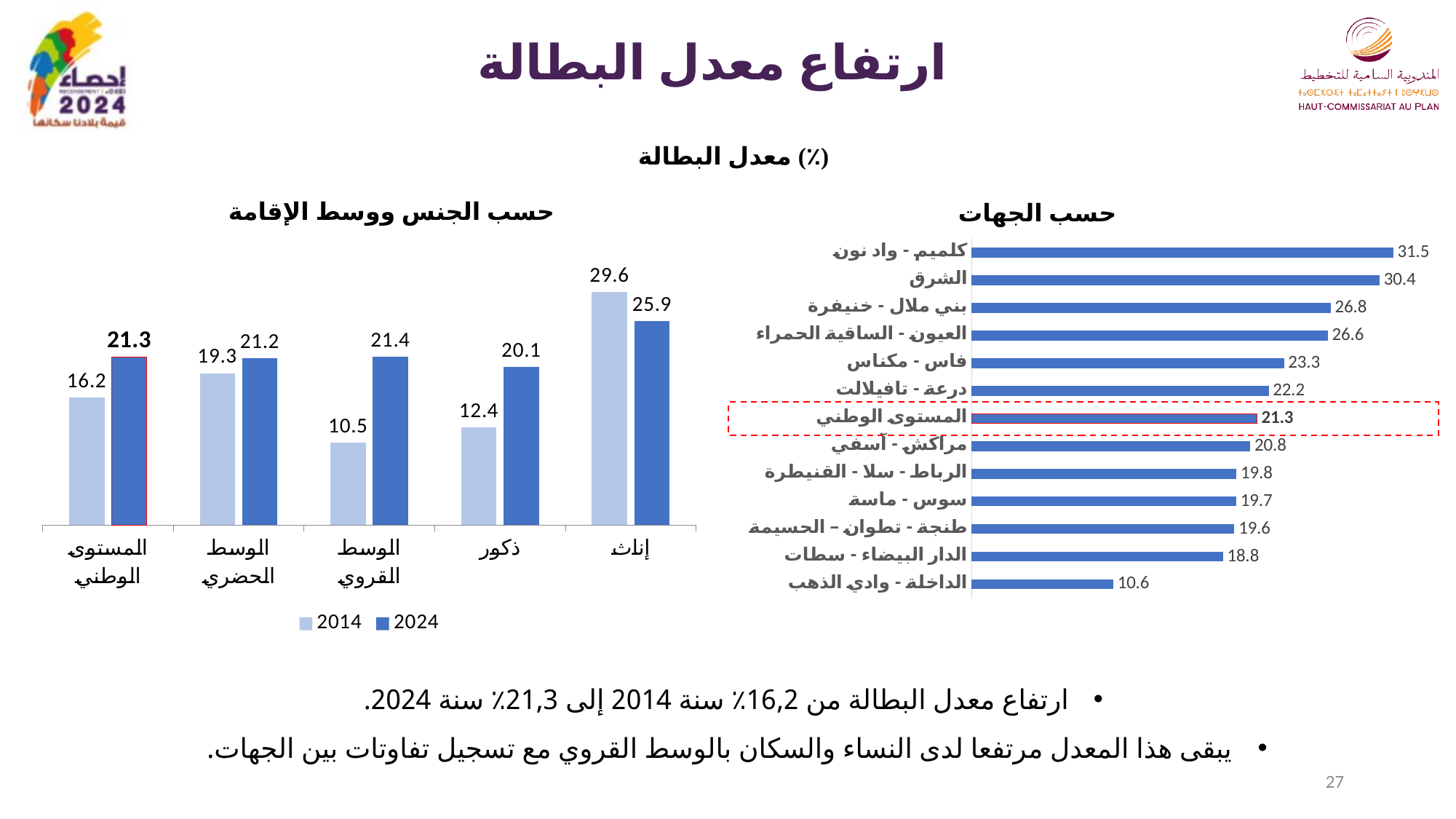
In the chart titled "حسب الجنس ووسط الإقامة", what is the 2014 value for الوسط القروي? 10.5 In the chart titled "حسب الجنس ووسط الإقامة", how many series does the legend list? 2 In the chart titled "حسب الجهات", how many bars are plotted? 13 In the chart titled "حسب الجنس ووسط الإقامة", which category has the highest 2014 value? إناث In the chart titled "حسب الجهات", which region has the highest value? كلميم - واد نون In the chart titled "حسب الجنس ووسط الإقامة", what kind of chart is it? Bar chart In the chart titled "حسب الجهات", which region has the lowest value? الداخلة - وادي الذهب In the chart titled "حسب الجهات", what is the value for فاس - مكناس? 23.3 In the chart titled "حسب الجنس ووسط الإقامة", what is the difference between the 2024 and 2014 values for المستوى الوطني? 5.1 In the chart titled "حسب الجنس ووسط الإقامة", what is the 2024 value for إناث? 25.9 In the chart titled "حسب الجنس ووسط الإقامة", which is larger for ذكور: the 2014 value or the 2024 value? 2024 In the chart titled "حسب الجهات", what is the difference between the values for الشرق and الدار البيضاء - سطات? 11.6